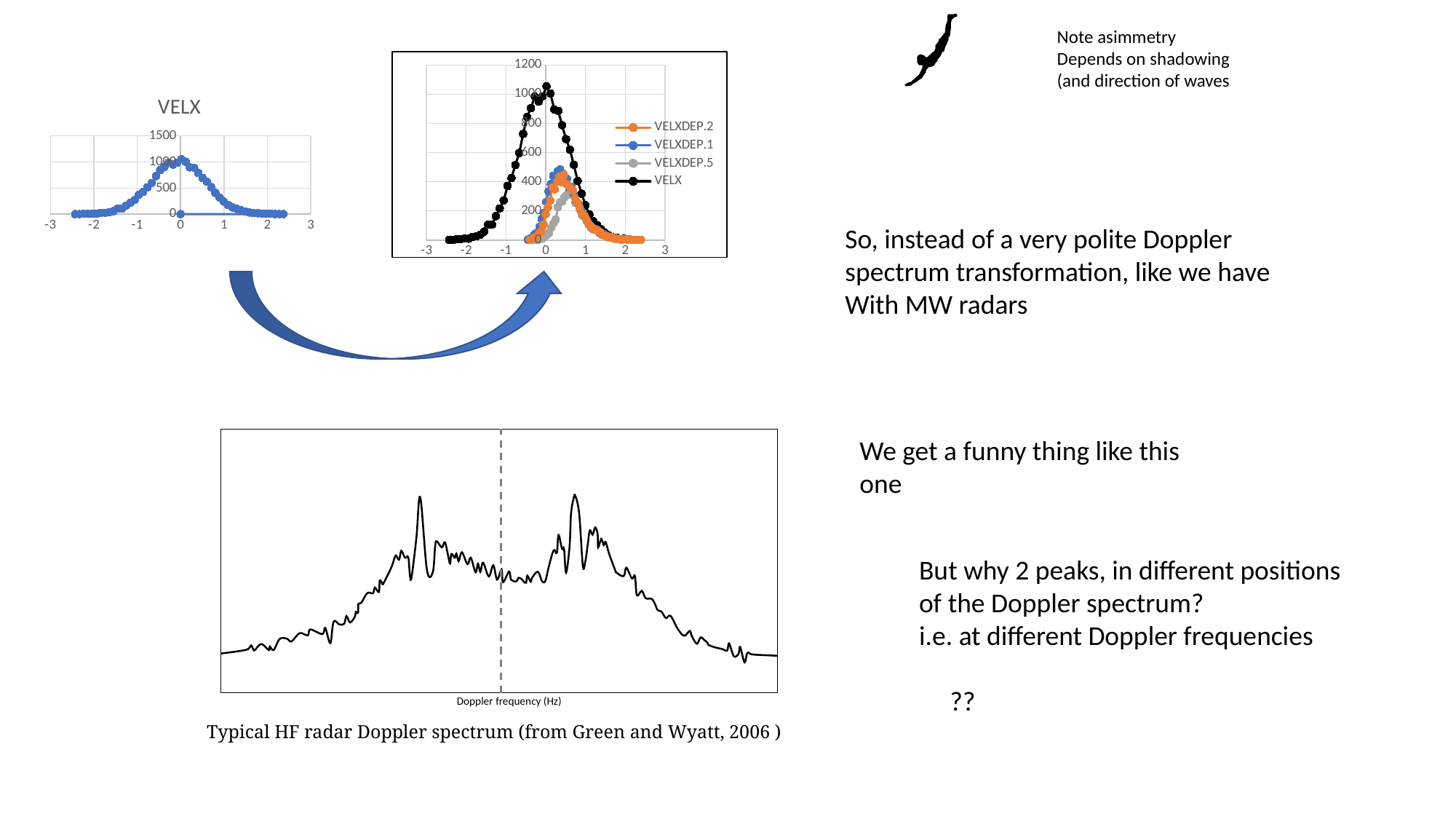
In the top-middle chart, is the peak value of VELX greater or less than 800? greater What is the title of the top-left chart? VELX In the top-left VELX chart, is the peak value greater or less than 1500? less In the top-left VELX chart, do the values rise or fall as x goes from 0 to 2? fall In the top-middle chart, what colour is the VELX series? black What is the x-axis label of the bottom chart (Typical HF radar Doppler spectrum)? Doppler frequency (Hz) In the top-middle chart, is the peak value of VELXDEP.5 greater or less than 600? less In the top-middle chart, which series reaches the highest peak value? VELX In the top-middle chart, which series has a higher peak, VELX or VELXDEP.5? VELX How many series does the legend of the top-middle chart list? 4 In the top-middle chart, which series has the lowest peak value? VELXDEP.5